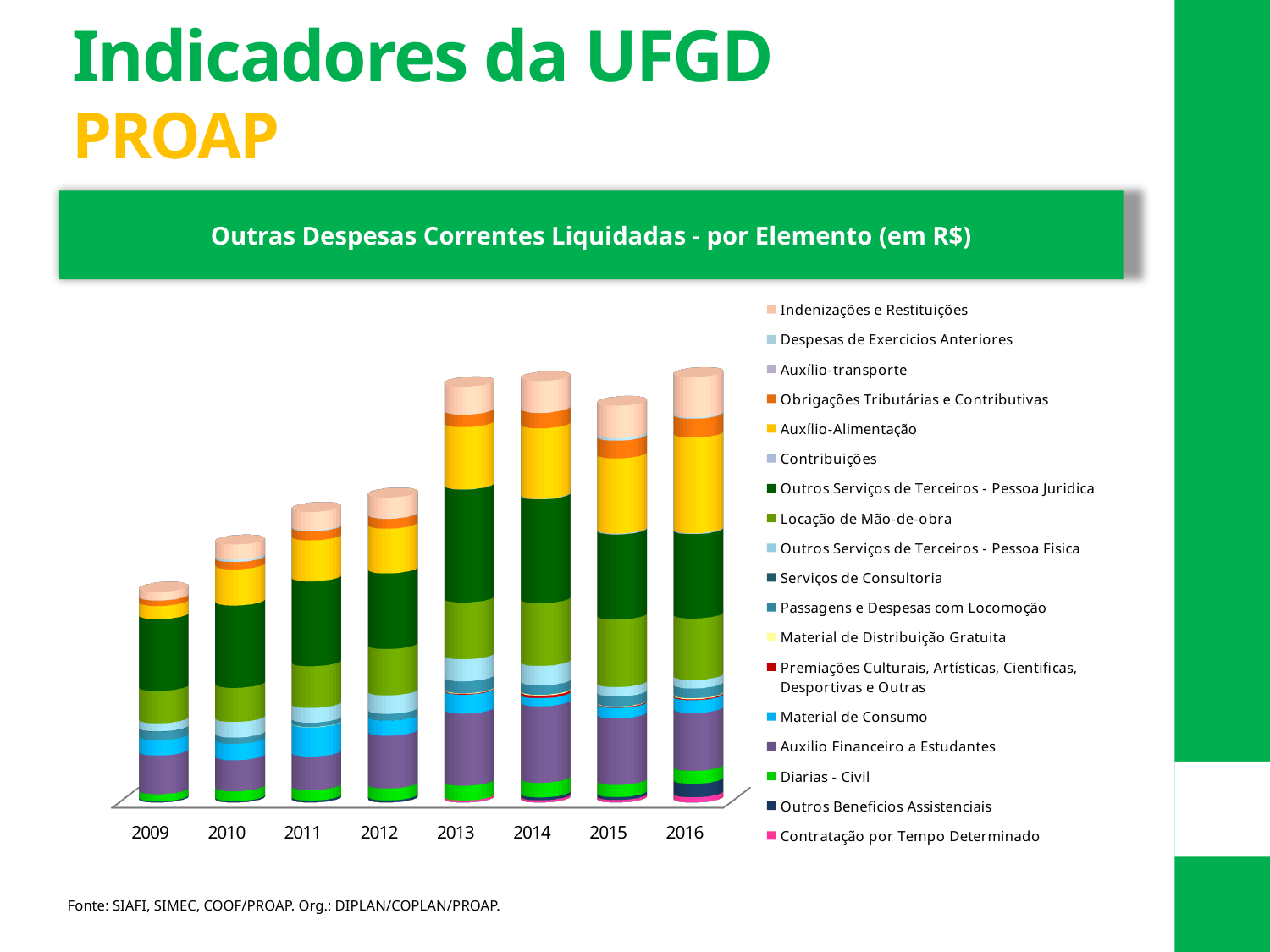
Which year has the lowest total of Outras Despesas Correntes Liquidadas? 2009 What is the first year shown on the x axis? 2009 What is the title of the chart? Outras Despesas Correntes Liquidadas - por Elemento (em R$) Do the total bar heights generally rise or fall from 2009 to 2013? rise How many years are shown along the x axis of the chart? 8 What kind of chart is shown on the slide? stacked bar chart Which year has the larger total bar, 2012 or 2015? 2015 Which year has the larger total bar, 2009 or 2013? 2013 How many series does the chart's legend list? 18 Which year has the larger total bar, 2010 or 2011? 2011